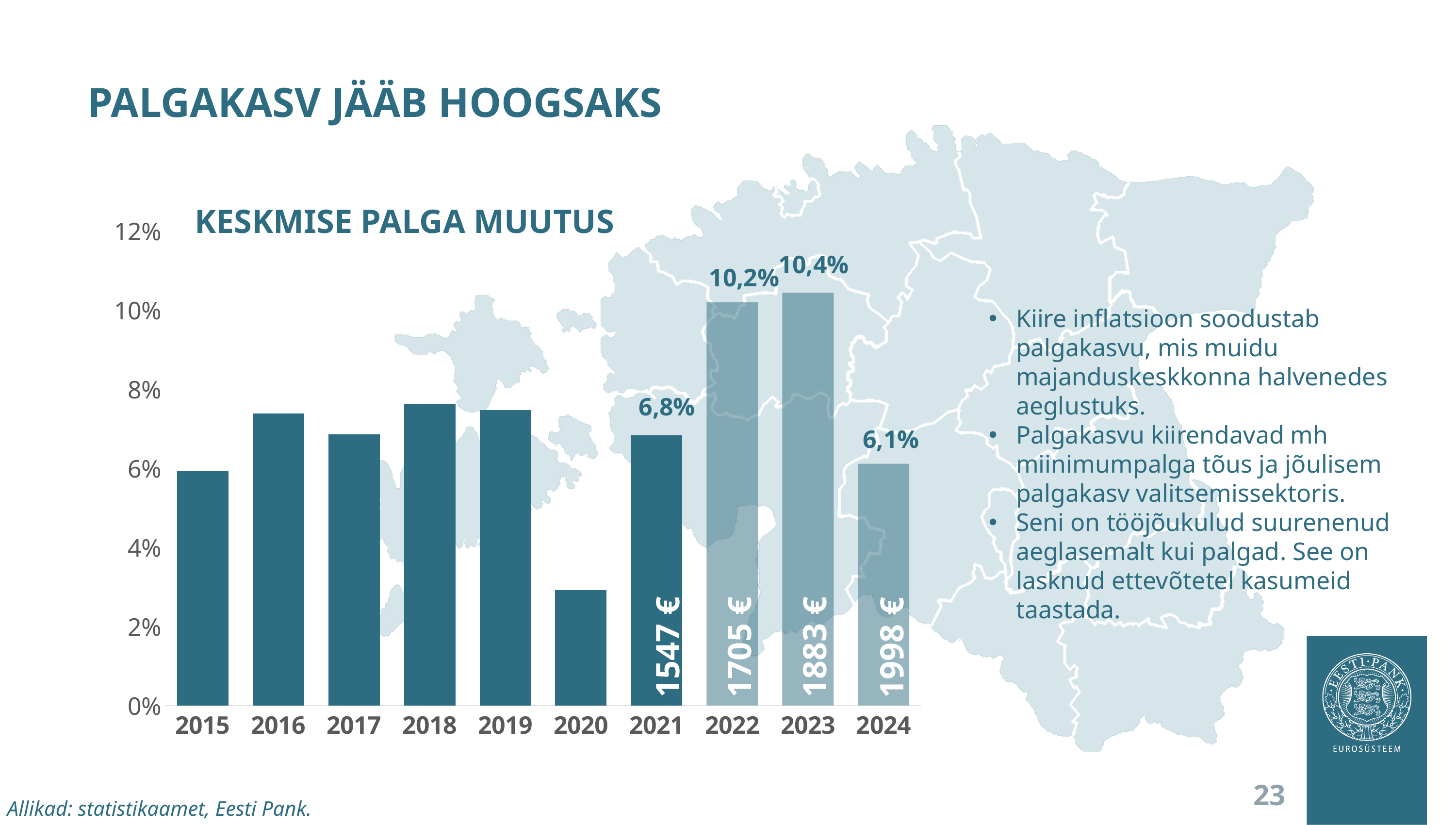
Do the values rise or fall from 2023 to 2024? fall What is the value for 2024 in the KESKMISE PALGA MUUTUS chart? 6,1% What average wage in euros is printed on the 2023 bar? 1883 € Is the value for 2020 greater or less than 4%? less What is the value for 2022 in the KESKMISE PALGA MUUTUS chart? 10,2% Is the value for 2018 greater or less than 6%? greater Which year has the highest value in the KESKMISE PALGA MUUTUS chart? 2023 How many years are shown on the x axis of the chart? 10 Which is larger, the value for 2021 or the value for 2024? 2021 Which year has the lowest value in the KESKMISE PALGA MUUTUS chart? 2020 What is the difference between the euro amounts printed on the 2024 and 2021 bars? 451 € What kind of chart is shown on the slide? bar chart